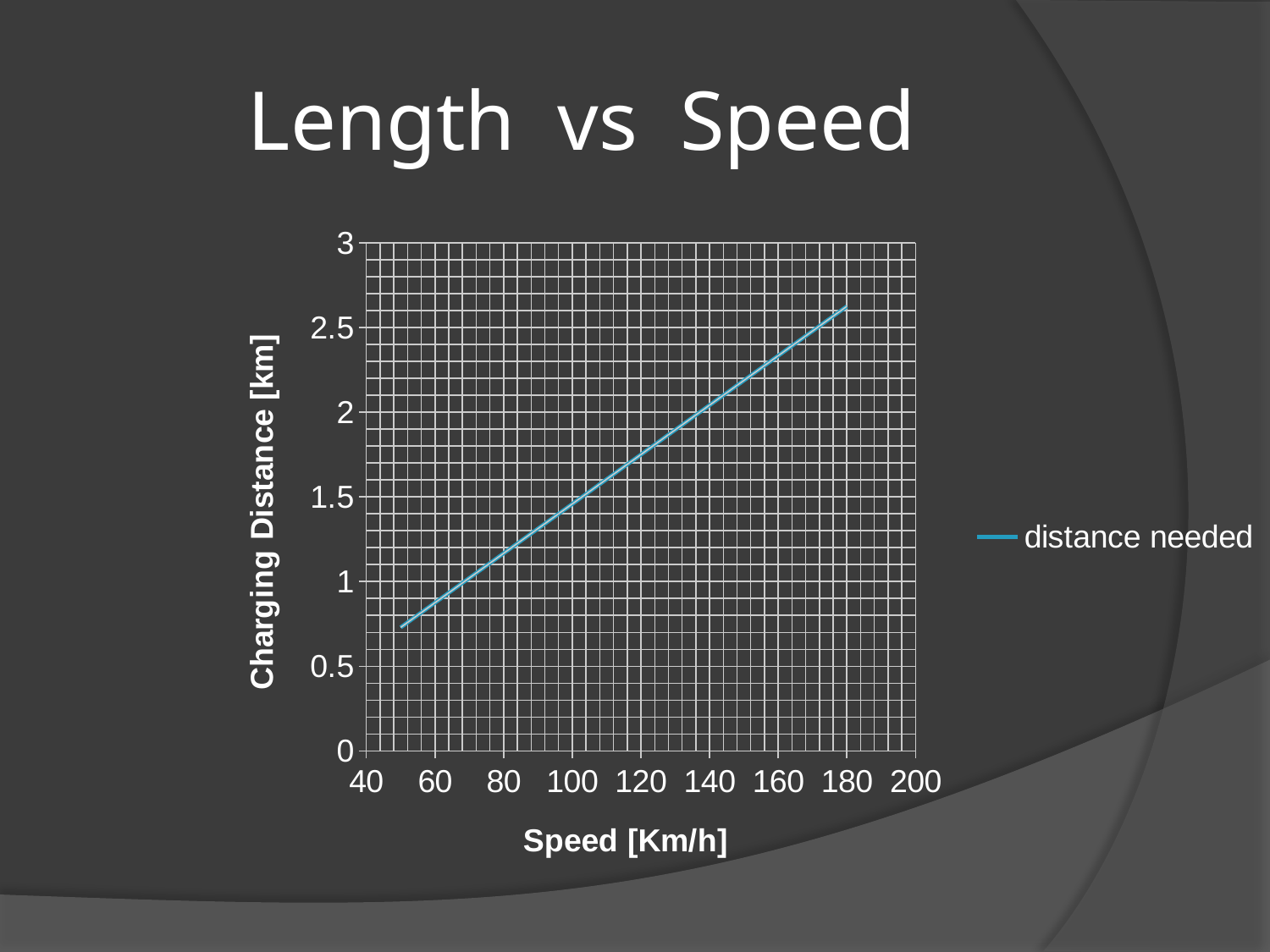
How many series does the legend list? 1 Is the charging distance larger at 150 Km/h or at 100 Km/h? 150 Km/h Is the charging distance at a speed of 100 Km/h greater or less than 1 km? greater Is the charging distance at a speed of 120 Km/h greater or less than 1.5 km? greater Which speed shown on the line has the highest charging distance, 50 Km/h or 180 Km/h? 180 Km/h What is the title of the chart's y axis? Charging Distance [km] Is the charging distance at a speed of 60 Km/h greater or less than 1 km? less What is the name of the series shown in the legend? distance needed Does the charging distance rise or fall as speed increases along the x axis? rise What kind of chart is shown on the slide? line chart